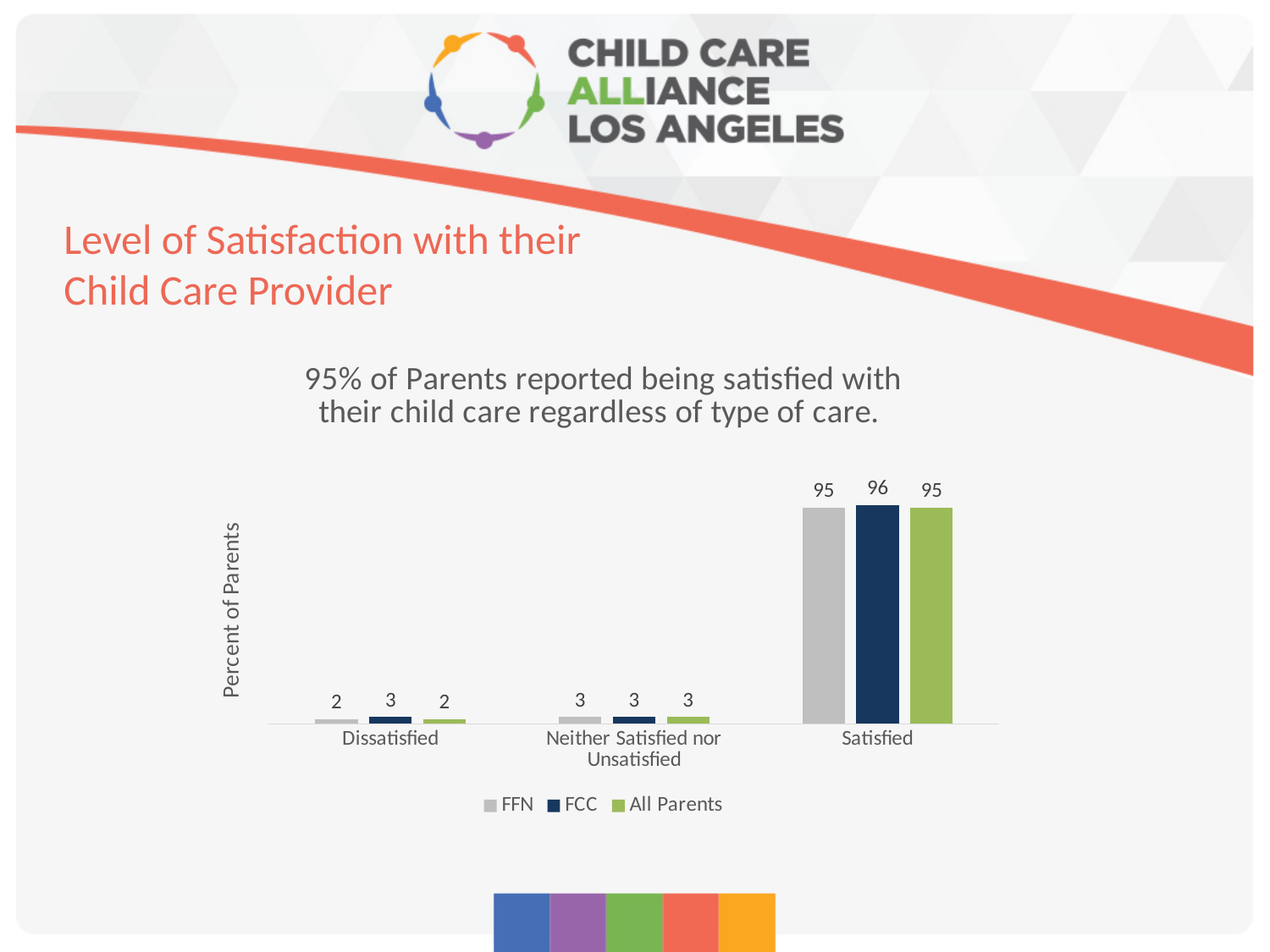
Which category has the lowest value for FFN? Dissatisfied What is the value for All Parents in the Neither Satisfied nor Unsatisfied category? 3 What is the difference between the FCC and FFN values in the Satisfied category? 1 How many series does the legend list? 3 Which is larger in the Dissatisfied category, the FCC value or the All Parents value? FCC Which series is shown in dark blue in the legend? FCC What is the value for FFN in the Dissatisfied category? 2 What is the value for FCC in the Satisfied category? 96 Which category has the highest value for All Parents? Satisfied What kind of chart is shown on the slide? Bar chart What is the label of the y axis? Percent of Parents How many categories are shown on the x axis? 3